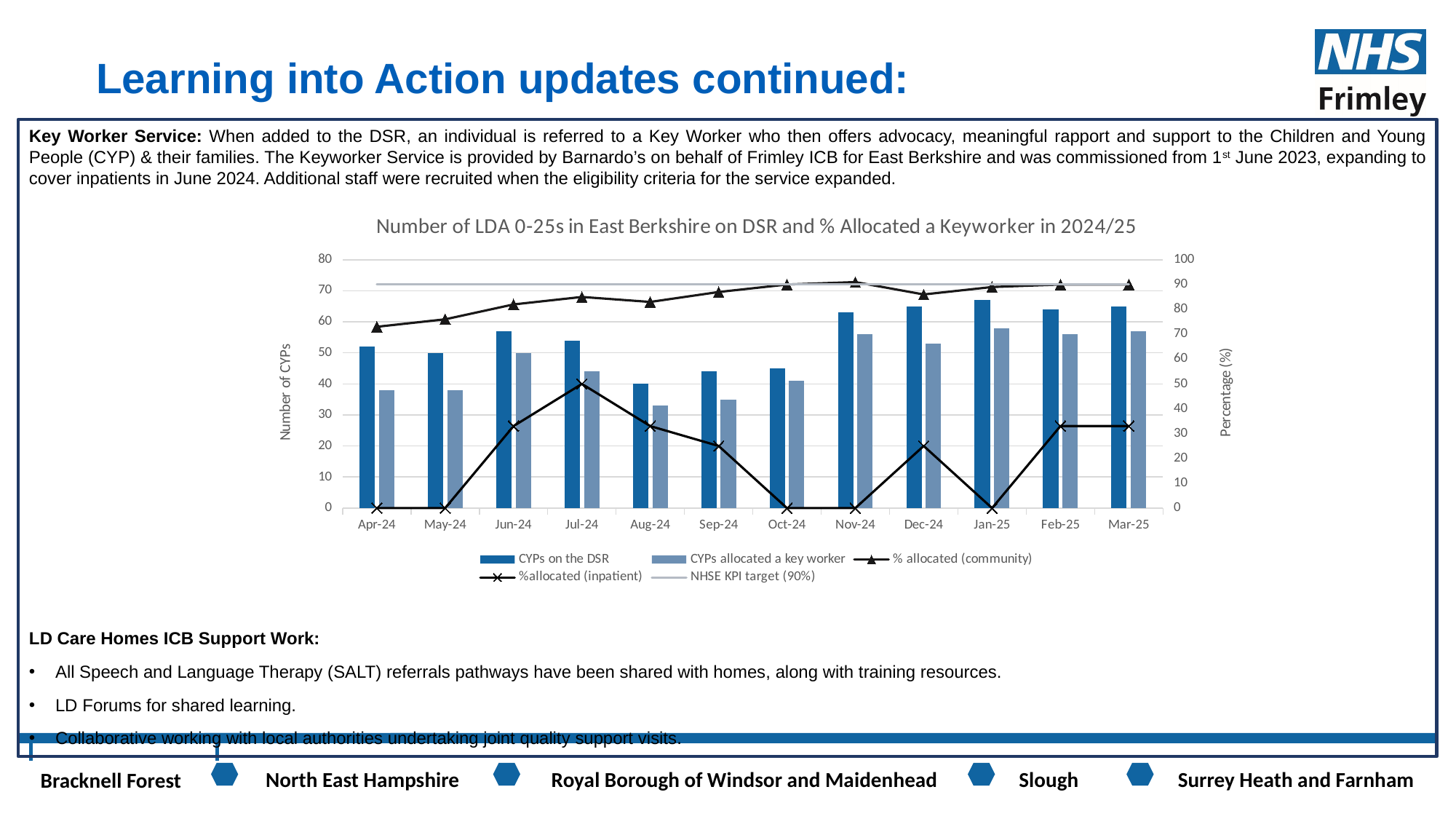
Is the value for CYPs on the DSR in Jan-25 greater or less than 60? greater How many months are shown on the x axis of the chart? 12 Which month has more CYPs on the DSR, Oct-24 or Nov-24? Nov-24 Is the value for CYPs allocated a key worker in Jun-24 greater or less than 40? greater Is the value for CYPs on the DSR in Aug-24 greater or less than 50? less In which month is the number of CYPs on the DSR lowest? Aug-24 How many series does the chart's legend list? 5 In which month is the % allocated (inpatient) line at its highest? Jul-24 What kind of chart is shown on the slide? A combined bar and line chart Does the % allocated (community) line rise or fall from Apr-24 to Jul-24? rise